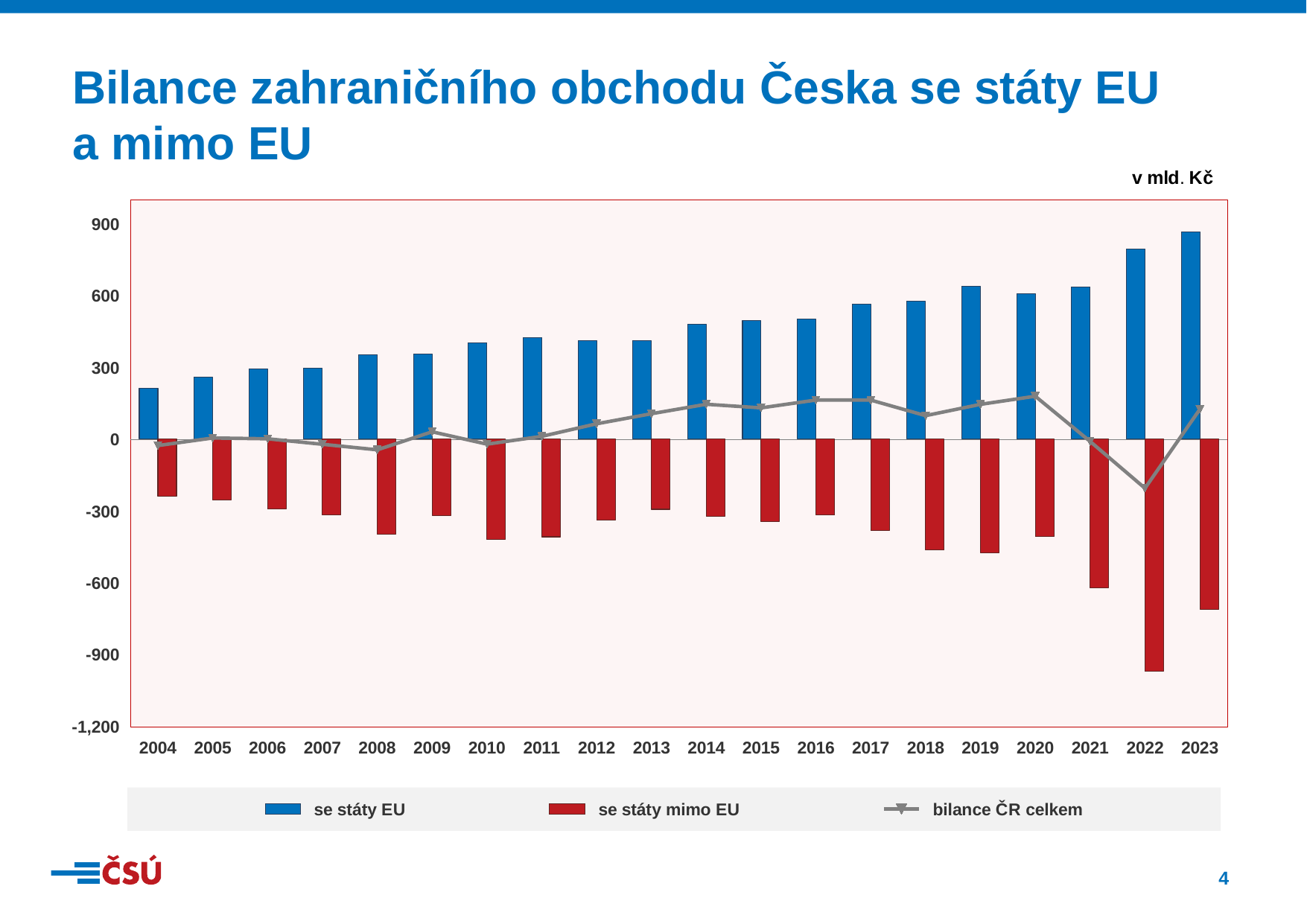
What kind of chart is shown on the slide? bar chart with a line Do the values for 'se státy EU' generally rise or fall from 2004 to 2023? rise Is the value for 'se státy EU' in 2023 greater or less than 600? greater In which year is the value for 'se státy mimo EU' lowest (most negative)? 2022 How many years are shown on the x axis? 20 What unit is stated above the chart? v mld. Kč In which year is the value for 'se státy EU' highest? 2023 In which year is the value for 'se státy EU' lowest? 2004 In which year does the 'bilance ČR celkem' line reach its lowest point? 2022 Is the value for 'se státy mimo EU' in 2022 greater or less than -900? less How many series does the legend list? 3 Which year has the larger value for 'se státy EU', 2019 or 2022? 2022